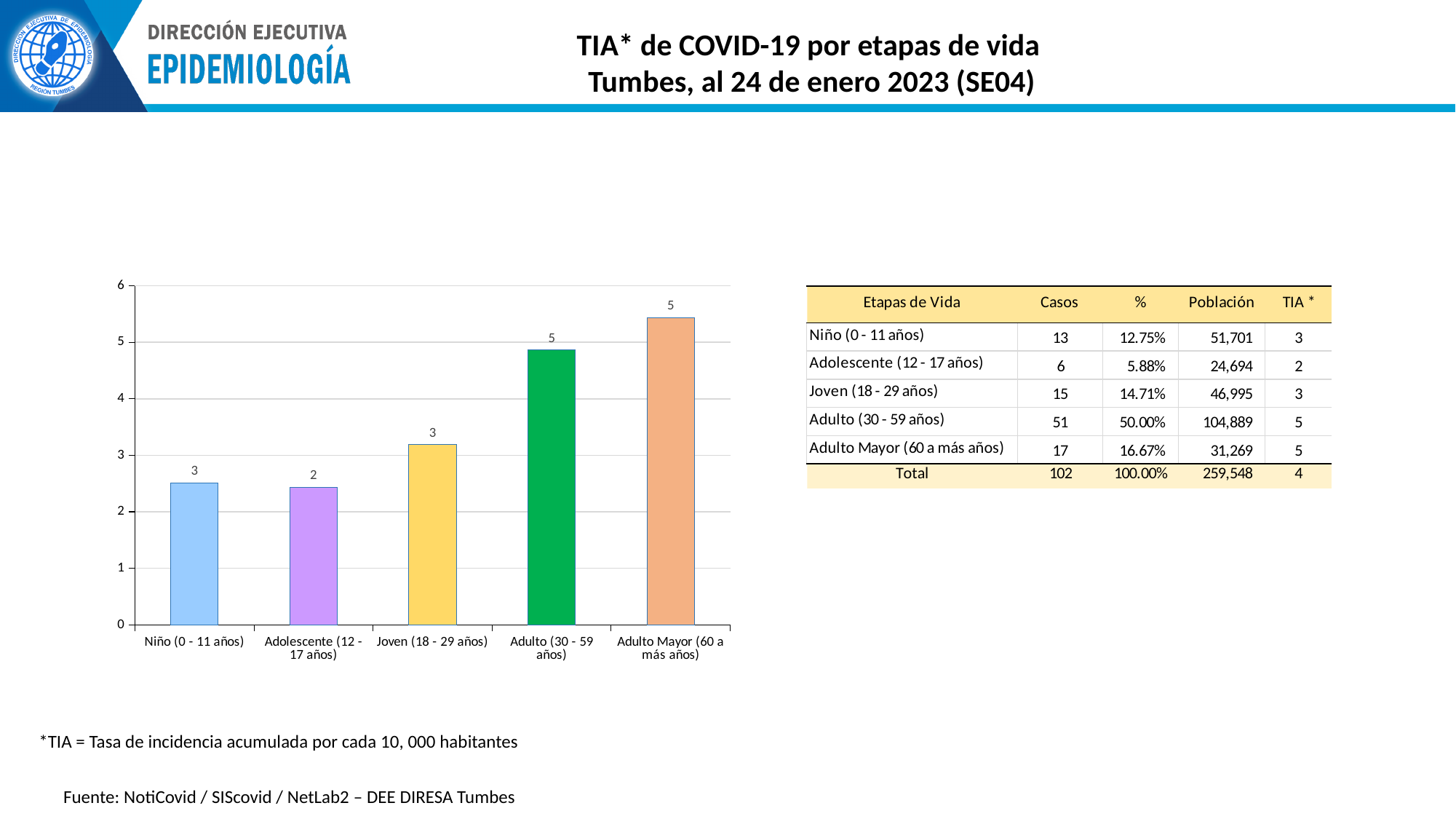
What is the TIA value shown for Niño (0 - 11 años)? 3 What is the TIA value shown for Adulto (30 - 59 años)? 5 What is the difference between the labelled values for Adulto (30 - 59 años) and Adolescente (12 - 17 años)? 3 Which bar is taller, Joven (18 - 29 años) or Adulto (30 - 59 años)? Adulto (30 - 59 años) Which life stage has the tallest bar in the chart? Adulto Mayor (60 a más años) What is the TIA value shown for Joven (18 - 29 años)? 3 What is the TIA value shown for Adolescente (12 - 17 años)? 2 How many life-stage categories are plotted in the chart? 5 What kind of chart is used to show the TIA by life stage? Bar chart Do the bar values generally rise or fall from Niño to Adulto Mayor along the x axis? Rise